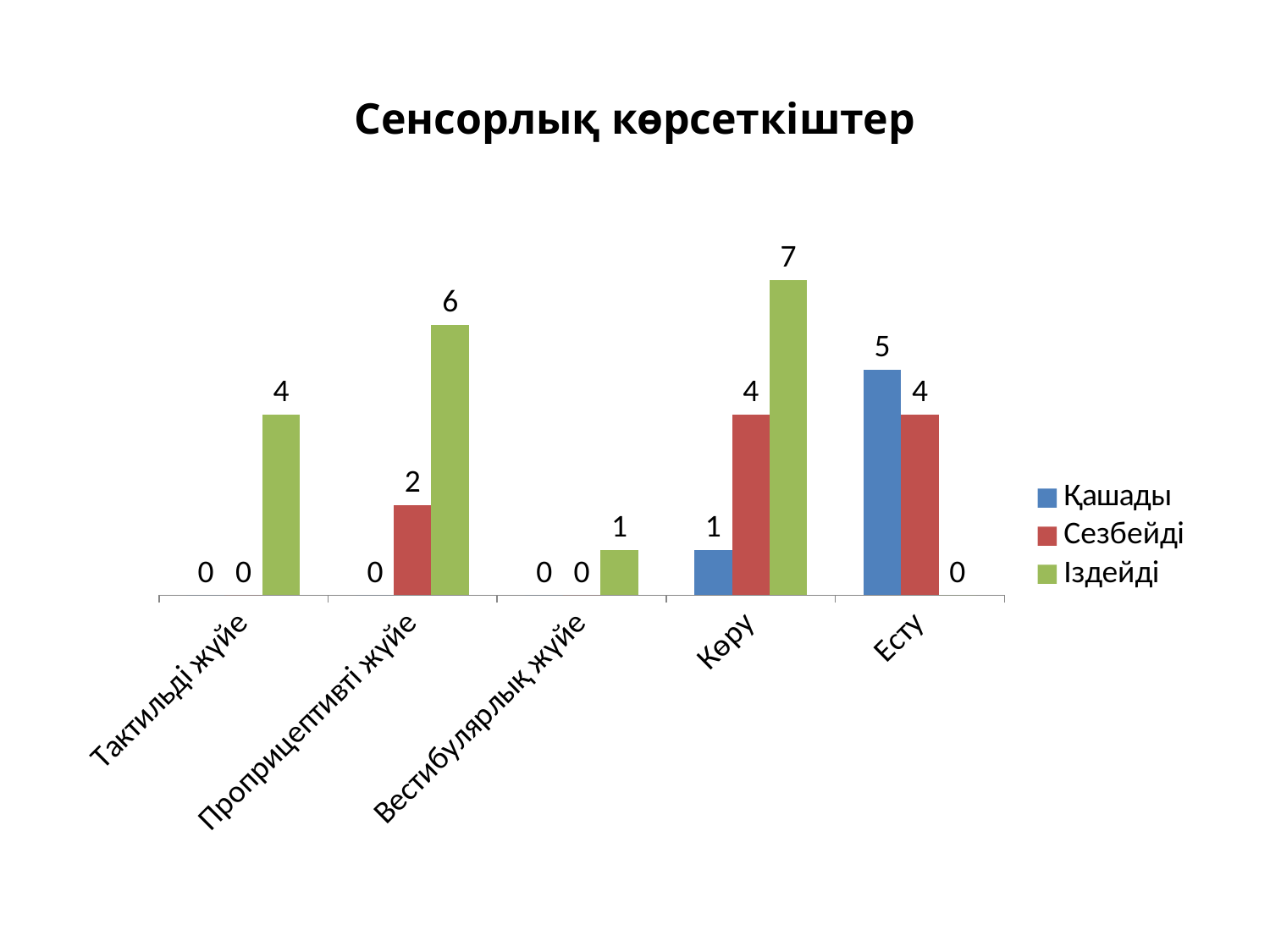
What is the value of Қашады for Есту? 5 What kind of chart is shown? Bar chart Which category has the highest Іздейді value? Көру What is the value of Іздейді for Вестибулярлық жүйе? 1 Which category has the lowest Сезбейді value among Проприцептивті жүйе, Көру and Есту? Проприцептивті жүйе What is the difference between the Іздейді values for Көру and Тактильді жүйе? 3 What is the value of Іздейді for Көру? 7 How many series does the legend list? 3 What is the title of the chart? Сенсорлық көрсеткіштер Which is larger for Есту: Қашады or Сезбейді? Қашады What is the value of Сезбейді for Проприцептивті жүйе? 2 How many categories are shown on the x axis? 5